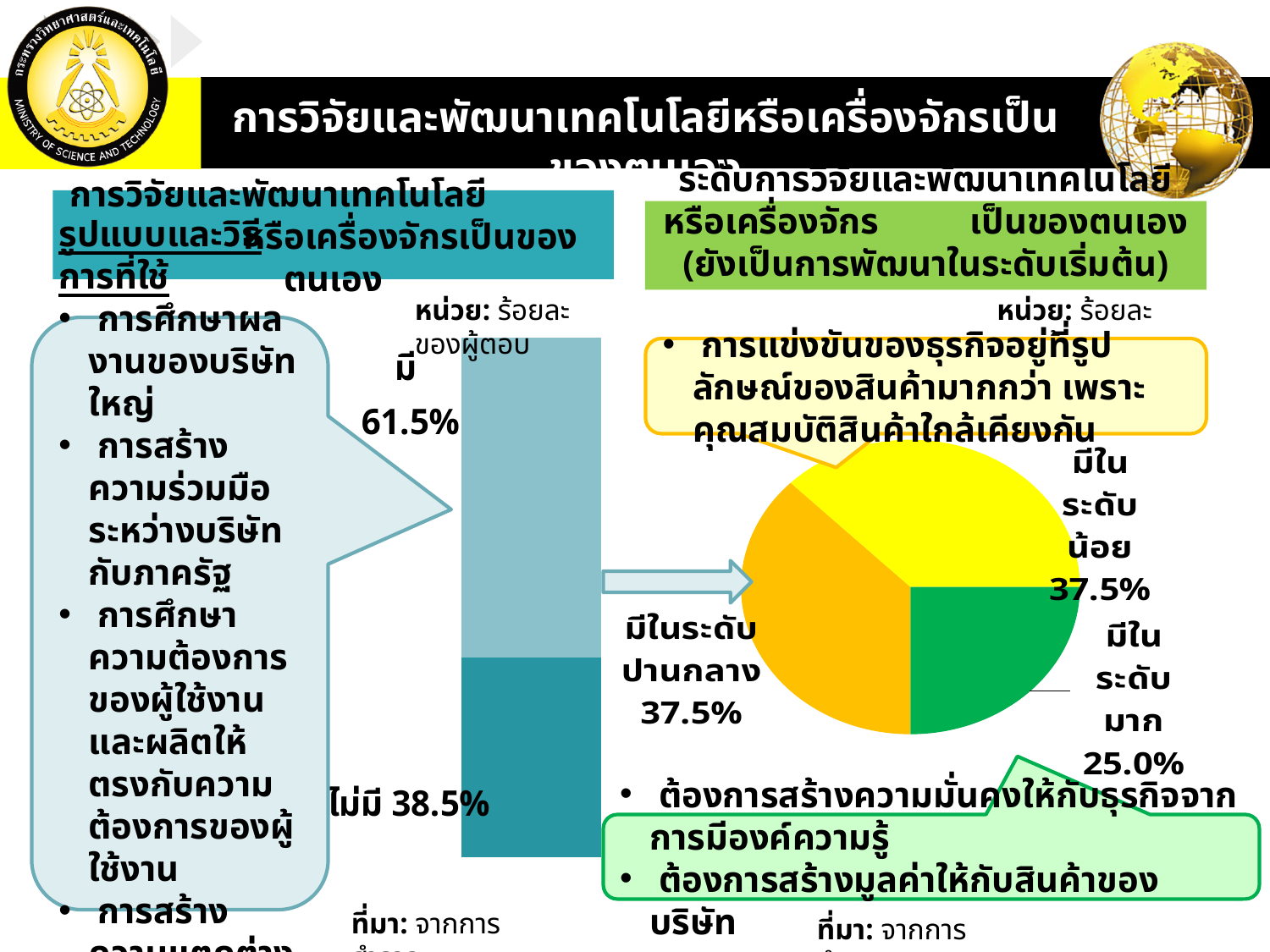
In the pie chart on the right, what is the difference between the "มีในระดับน้อย" and "มีในระดับมาก" shares? 12.5% What kind of chart is shown on the left side of the slide? Stacked bar chart In the bar chart on the left, what is the difference between the "มี" and "ไม่มี" percentages? 23% How many slices does the pie chart on the right have? 3 In the pie chart on the right, what percentage is shown for "มีในระดับมาก"? 25.0% In the bar chart on the left, what percentage is shown for "มี"? 61.5% In the pie chart on the right, which category has the smallest share? มีในระดับมาก In the bar chart on the left, which segment is larger, "มี" or "ไม่มี"? มี In the bar chart on the left, what percentage is shown for "ไม่มี"? 38.5% In the pie chart on the right, what percentage is shown for "มีในระดับปานกลาง"? 37.5% In the bar chart on the left, what is the total of the two stacked segments? 100% What kind of chart is shown on the right side of the slide? Pie chart